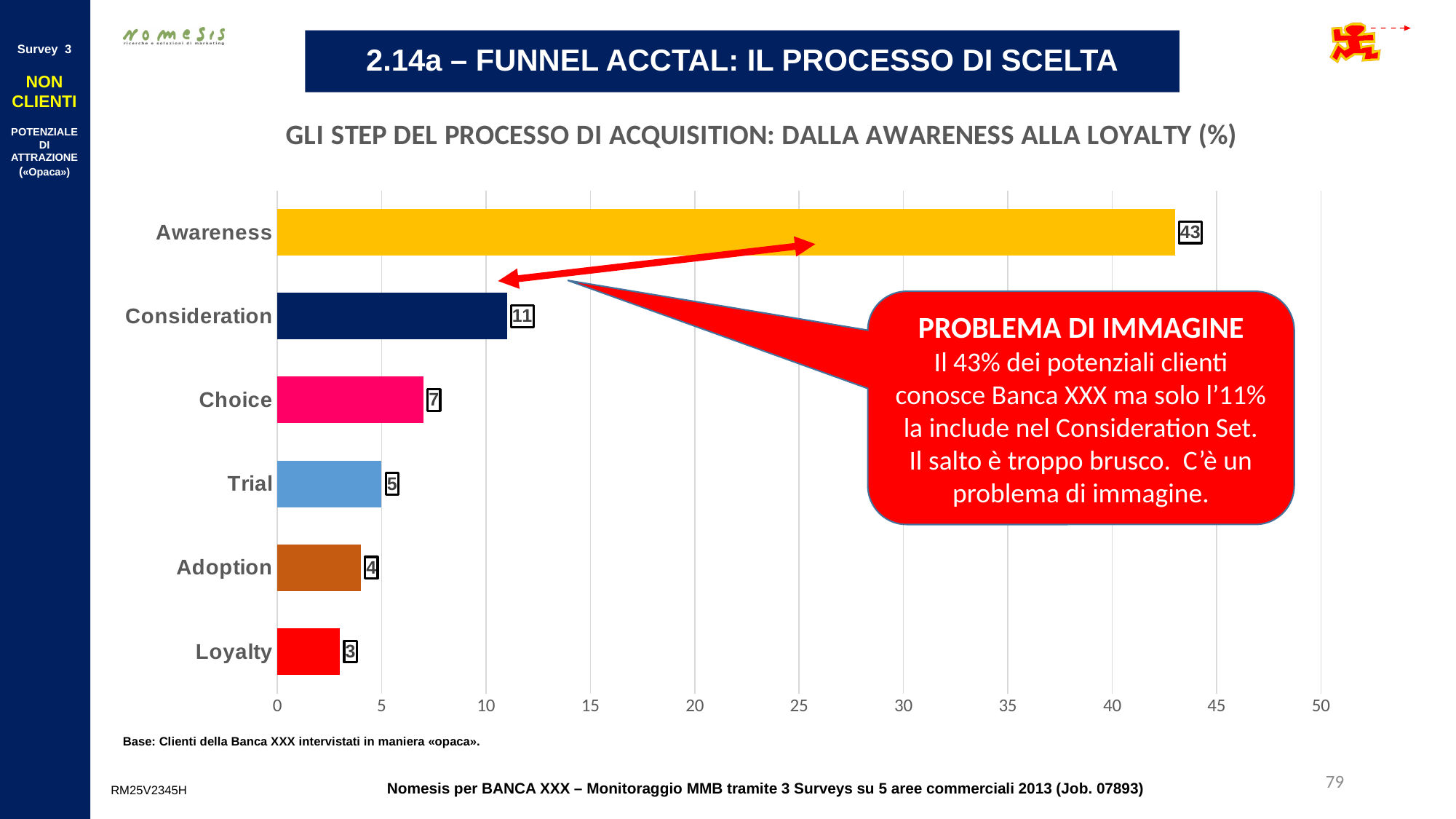
What is the difference between the values for Awareness and Consideration? 32 How many categories are shown in the chart? 6 Which is larger, the value for Choice or the value for Adoption? Choice What kind of chart is shown on the slide? Bar chart What is the value for Trial? 5 What is the value for Awareness? 43 What is the title of the chart? GLI STEP DEL PROCESSO DI ACQUISITION: DALLA AWARENESS ALLA LOYALTY (%) Is the value for Awareness greater or less than 40? greater Which category has the lowest value? Loyalty What is the value for Consideration? 11 Which category has the highest value? Awareness What is the value for Loyalty? 3